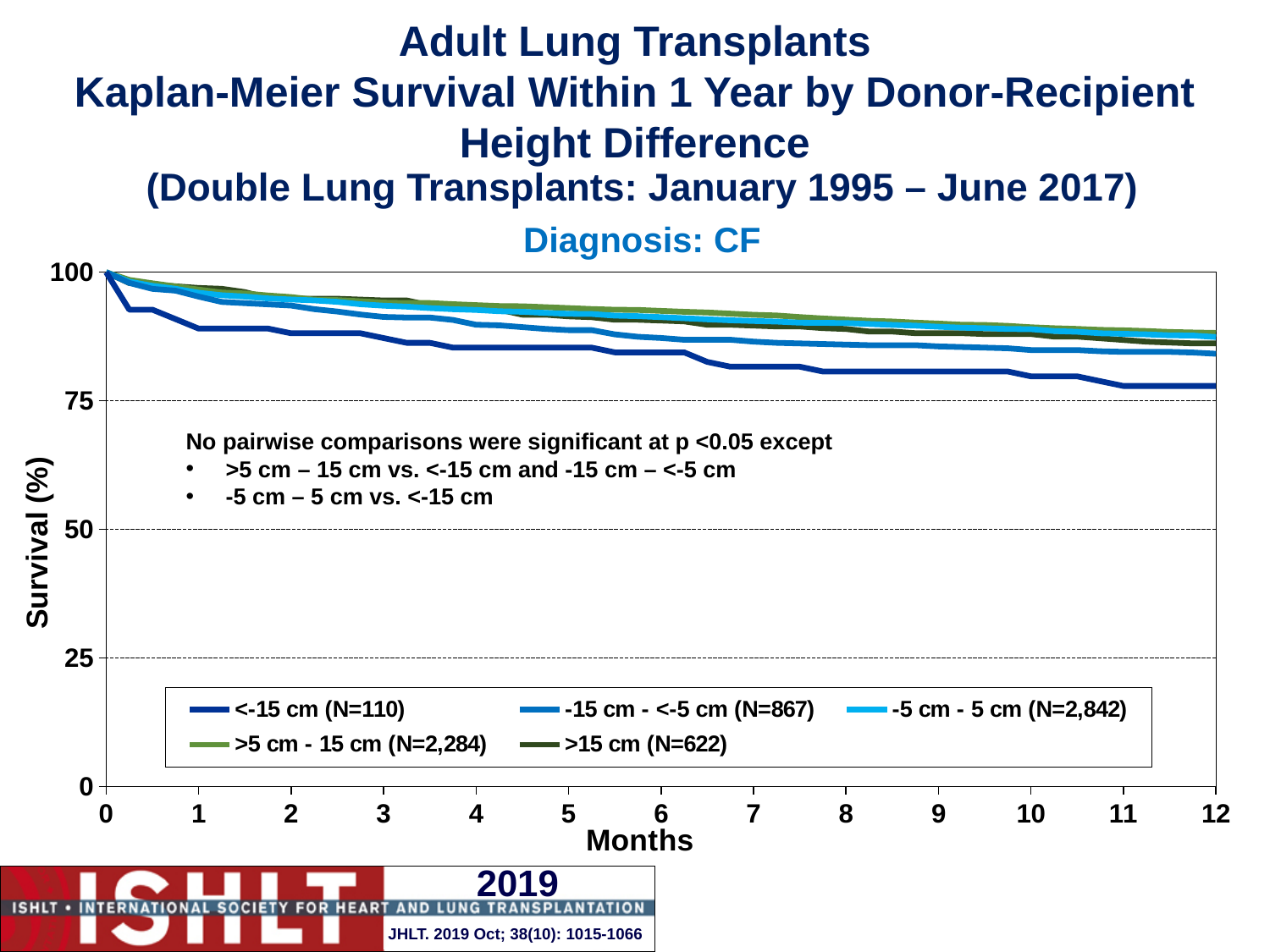
Which group has the lowest survival at 12 months? <-15 cm Is the survival for the <-15 cm group at 12 months greater or less than 75? greater At 12 months, which has higher survival: the <-15 cm group or the -15 cm - <-5 cm group? -15 cm - <-5 cm What is the diagnosis stated for this chart? CF Do the survival curves rise or fall as months increase? fall What is the label of the y axis? Survival (%) Is the survival for the >5 cm - 15 cm group at 6 months greater or less than 75? greater What kind of chart is shown on the slide? line chart What is the N for the -5 cm - 5 cm group shown in the legend? 2,842 What is the N for the <-15 cm group shown in the legend? 110 What is the N for the >15 cm group shown in the legend? 622 How many series does the legend list? 5